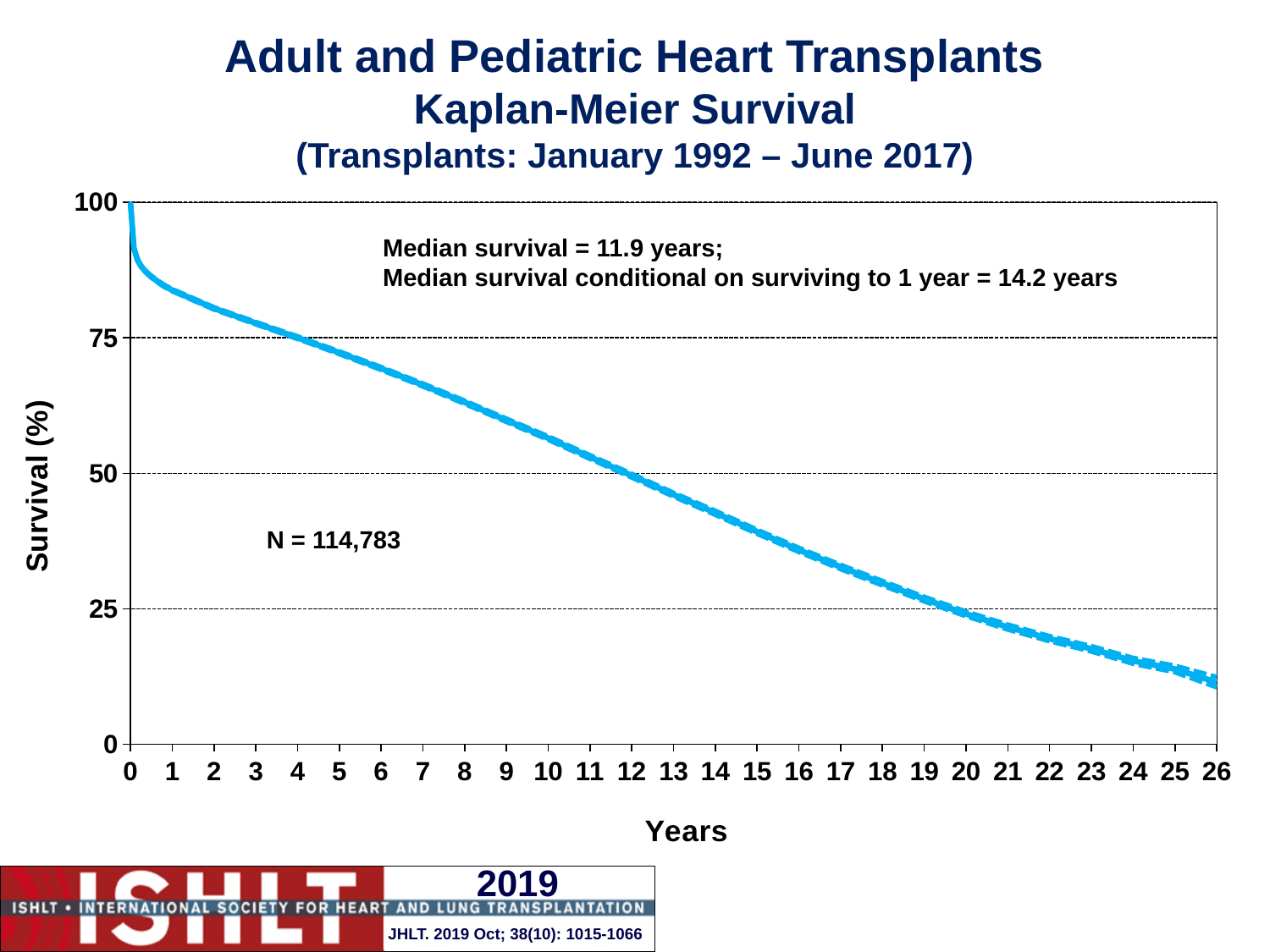
Is the survival value at 6 years greater or less than 75? less What is the median survival conditional on surviving to 1 year? 14.2 years Does the survival curve rise or fall as years increase? Fall Is the survival value at 8 years greater or less than 50? greater What kind of chart is shown on the slide? Line chart Is the survival value at 16 years greater or less than 50? less What is the N (number of transplants) shown on the chart? 114,783 What is the median survival stated on the slide? 11.9 years What is the highest value shown on the x axis (Years)? 26 What is the label of the y axis? Survival (%)